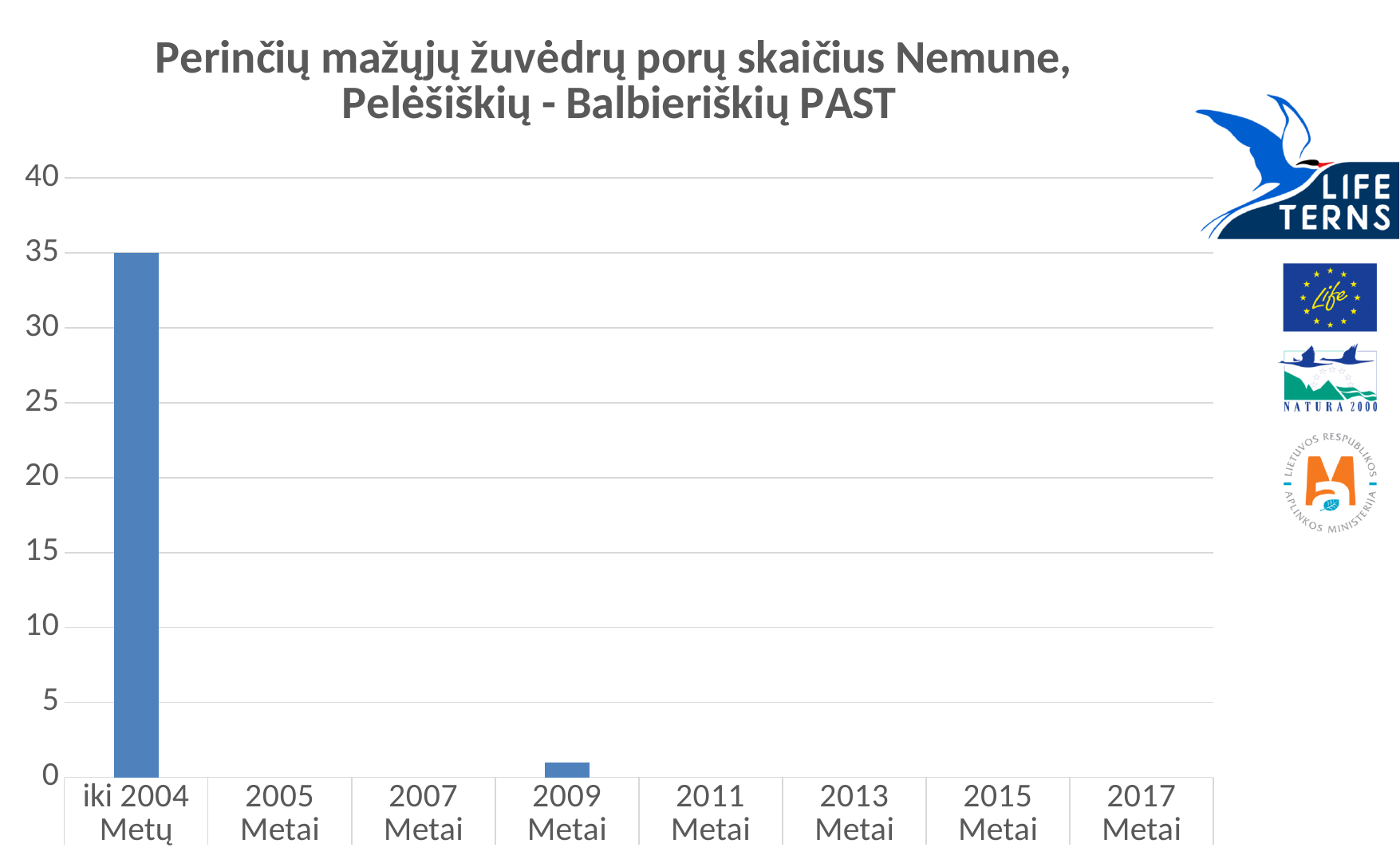
Is the value for 2009 Metai greater or less than 5? less Which is larger, the value for iki 2004 Metų or the value for 2009 Metai? iki 2004 Metų How many categories have a visible bar above zero? 2 Do the values generally rise or fall from left to right along the x axis? fall What is the title of the chart? Perinčių mažųjų žuvėdrų porų skaičius Nemune, Pelėšiškių - Balbieriškių PAST Which category has the highest value? iki 2004 Metų What kind of chart is shown on the slide? bar chart What is the value for iki 2004 Metų? 35 How many categories are shown on the x axis? 8 Is the value for iki 2004 Metų greater or less than 30? greater What is the highest value shown on the y axis? 40